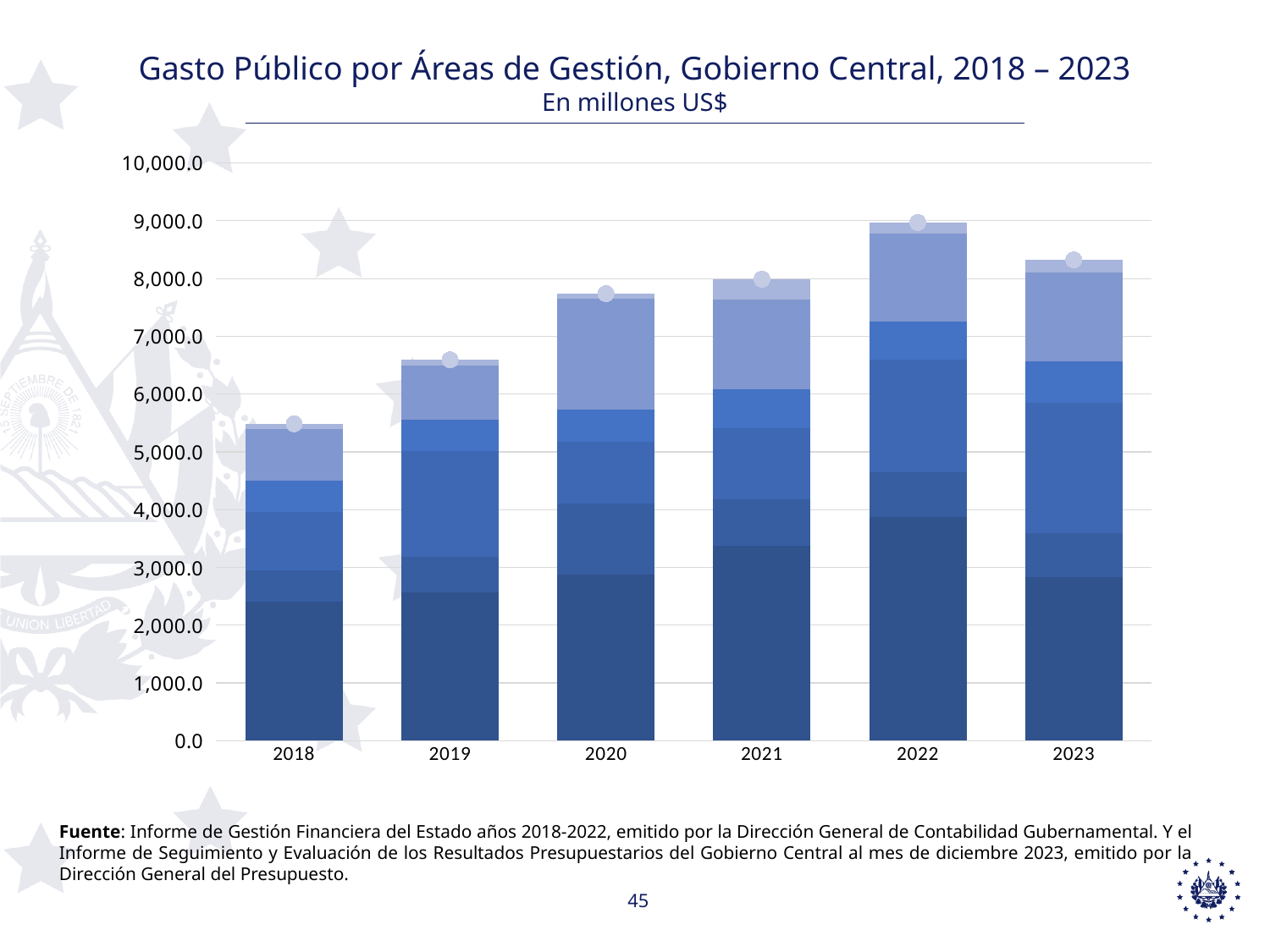
What kind of chart is shown on the slide? Stacked bar chart Do the total bars rise or fall from 2018 to 2022? rise Is the total bar for 2022 greater or less than 8,000.0? greater Is the total bar for 2018 greater or less than 6,000.0? less How many years are shown on the x axis of the chart? 6 Is the total bar for 2020 greater or less than 7,000.0? greater Which year has the highest total public spending in the chart? 2022 Which year has a larger total bar, 2022 or 2023? 2022 In what units are the values in the chart expressed, according to the subtitle? En millones US$ Which year has a larger total bar, 2019 or 2021? 2021 Which year has the lowest total public spending in the chart? 2018